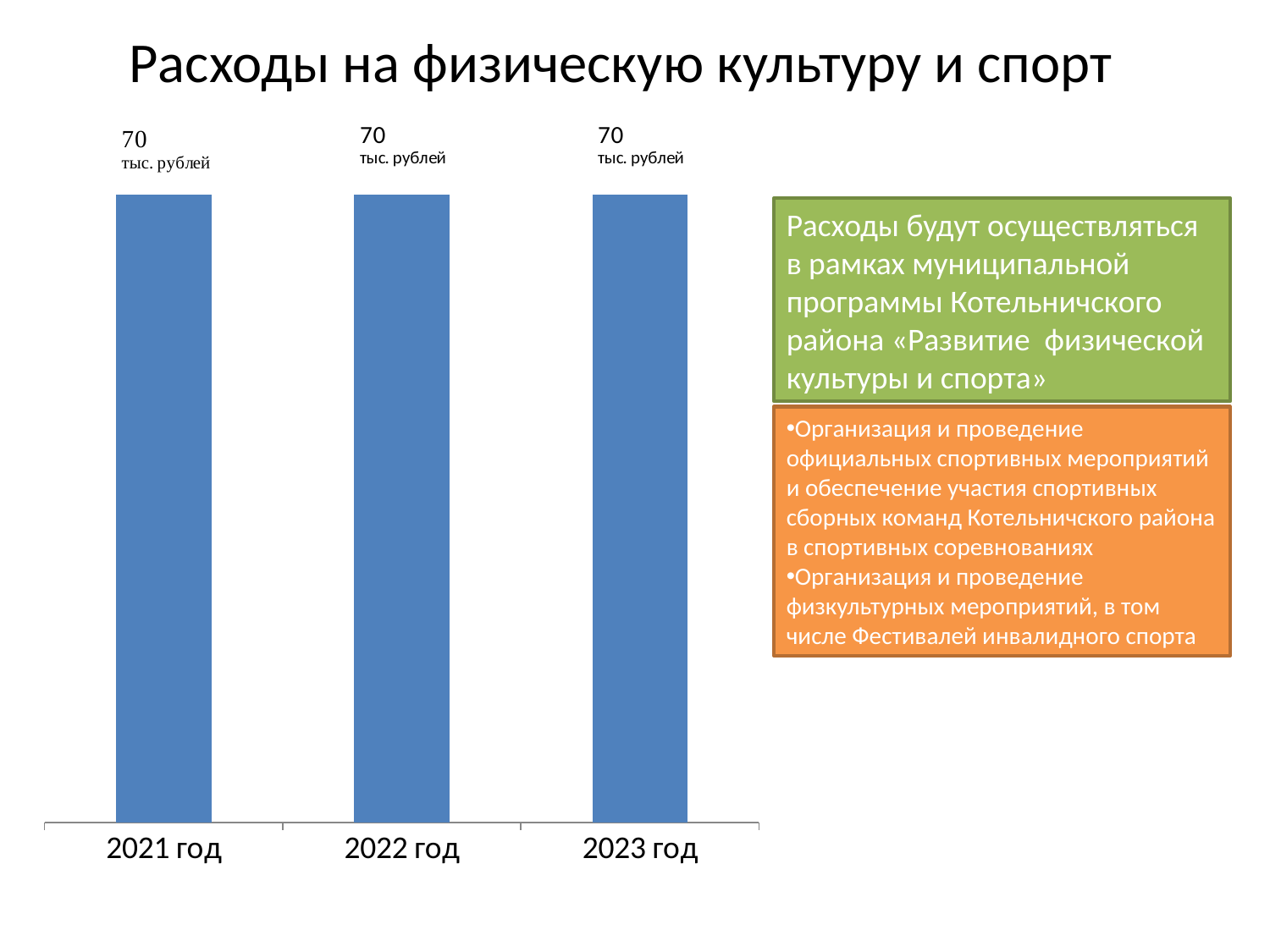
Do the values rise, fall or stay the same from 2021 год to 2023 год? stay the same What is the value for 2021 год? 70 тыс. рублей What is the difference between the values for 2022 год and 2021 год? 0 How many categories are shown on the x axis of the chart? 3 What is the total of the values for 2021 год, 2022 год and 2023 год? 210 тыс. рублей What is the title of the slide containing the chart? Расходы на физическую культуру и спорт What is the value for 2022 год? 70 тыс. рублей What is the difference between the values for 2023 год and 2021 год? 0 What is the value for 2023 год? 70 тыс. рублей What kind of chart is shown on the slide? bar chart What colour are the bars in the chart? blue